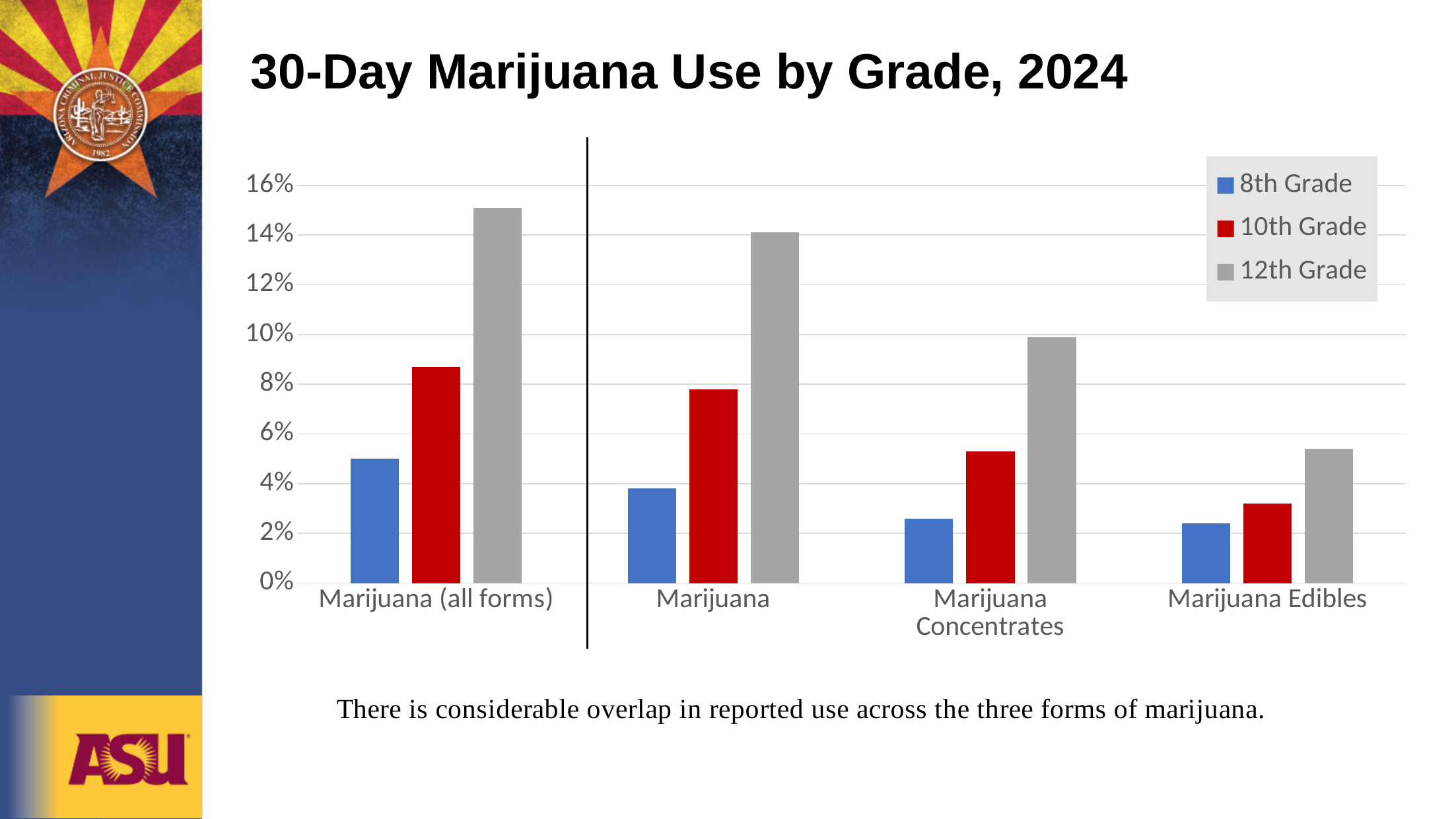
Is the 10th Grade value for Marijuana Concentrates greater or less than 4%? greater How many series does the legend list? 3 How many categories are shown on the x axis? 4 Which category has the lowest 12th Grade value? Marijuana Edibles Which category has the highest 10th Grade value? Marijuana (all forms) Is the 12th Grade value for Marijuana (all forms) greater or less than 14%? greater Which category has the highest 12th Grade value? Marijuana (all forms) Is the 12th Grade value for Marijuana Edibles greater or less than 6%? less Which is larger: the 10th Grade value for Marijuana or the 10th Grade value for Marijuana Edibles? Marijuana What colour represents 10th Grade in the legend? red Do the 12th Grade values rise or fall moving from left to right across the categories? fall What kind of chart is shown on the slide? bar chart